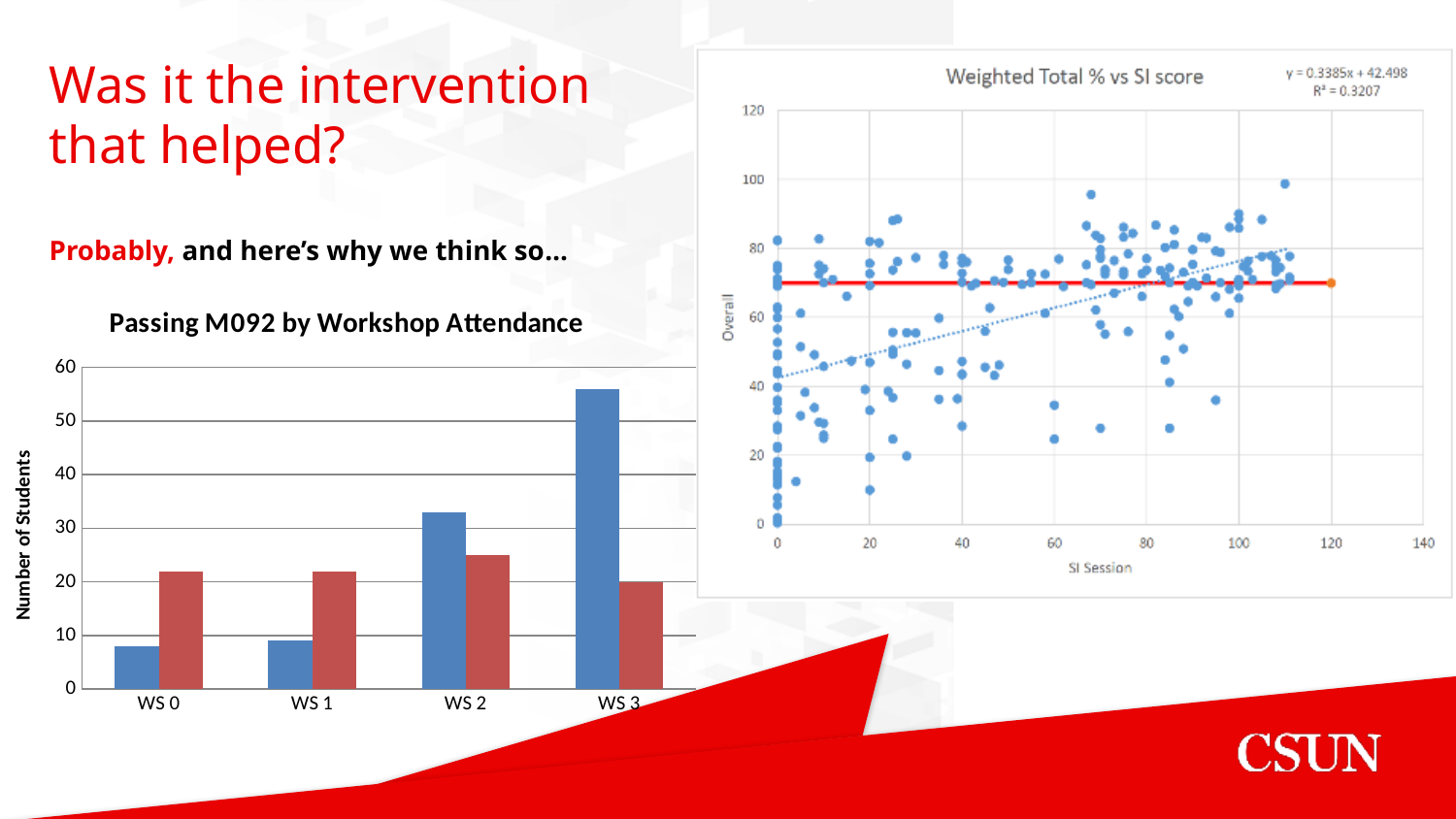
In 'Passing M092 by Workshop Attendance', do the blue bars rise or fall from WS 0 to WS 3? rise In 'Passing M092 by Workshop Attendance', is the blue bar for WS 0 greater or less than 10? less In 'Passing M092 by Workshop Attendance', which category has the tallest blue bar? WS 3 How many workshop attendance categories are shown on the x axis of 'Passing M092 by Workshop Attendance'? 4 In 'Passing M092 by Workshop Attendance', for WS 3, is the blue bar or the red bar taller? blue bar In 'Passing M092 by Workshop Attendance', for WS 0, is the blue bar or the red bar taller? red bar In 'Passing M092 by Workshop Attendance', is the red bar for WS 2 greater or less than 20? greater In 'Passing M092 by Workshop Attendance', is the blue bar for WS 3 greater or less than 50? greater What kind of chart is 'Weighted Total % vs SI score'? scatter chart In 'Passing M092 by Workshop Attendance', which category has the shortest blue bar? WS 0 What R² value is printed on the 'Weighted Total % vs SI score' chart? 0.3207 What kind of chart is 'Passing M092 by Workshop Attendance'? bar chart